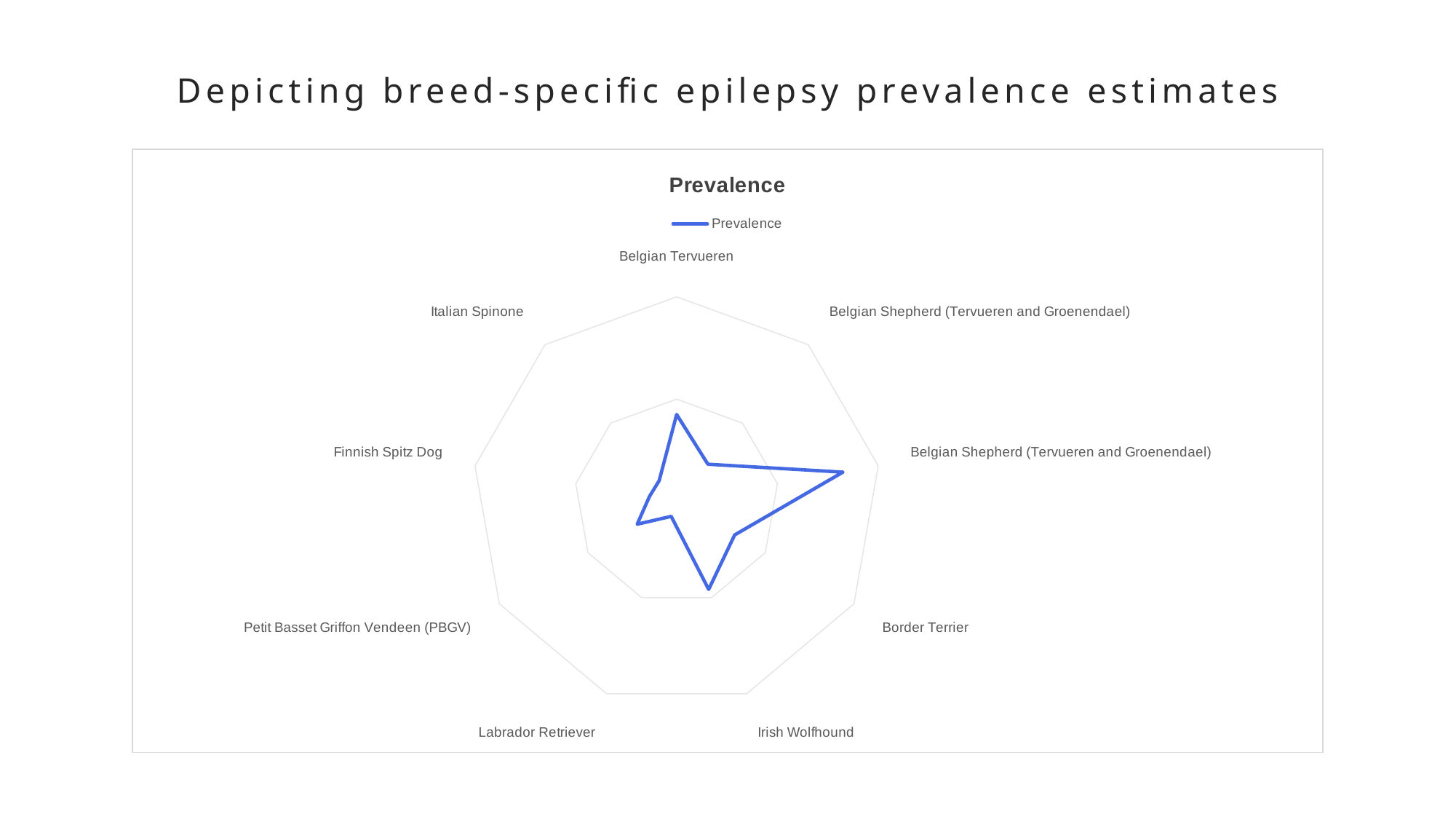
Which has the larger prevalence value, Irish Wolfhound or Labrador Retriever? Irish Wolfhound What kind of chart is shown on the slide? Radar chart What is the title of the chart? Prevalence How many breed categories are plotted on the radar chart? 9 What is the name of the series shown in the legend? Prevalence Which has the larger prevalence value, Border Terrier or Petit Basset Griffon Vendeen (PBGV)? Border Terrier How many series does the legend list? 1 Which category has the highest prevalence value on the chart? Belgian Shepherd (Tervueren and Groenendael) Which has the larger prevalence value, Irish Wolfhound or Belgian Tervueren? Irish Wolfhound